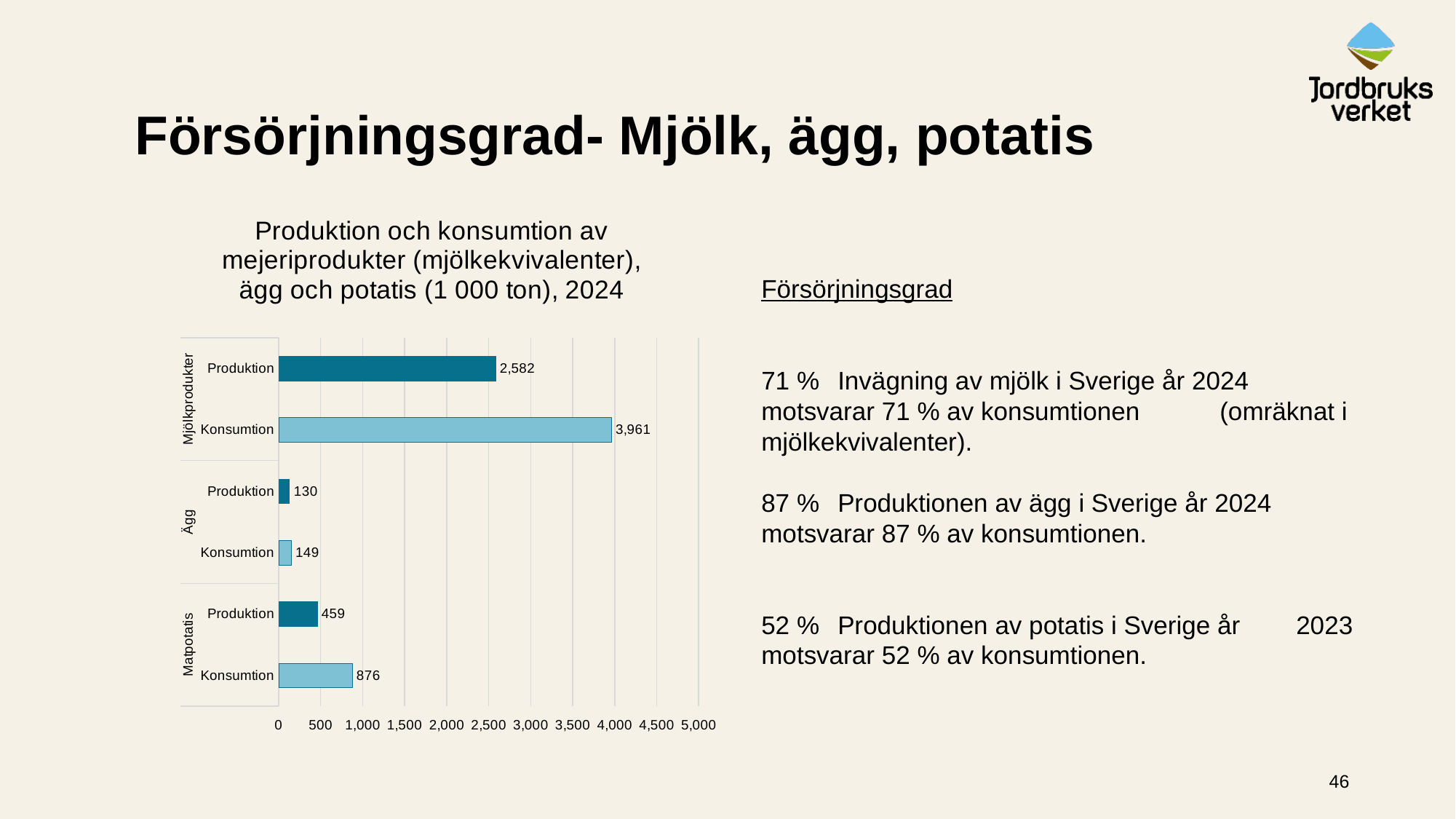
What is the value of Produktion for Ägg? 130 What is the value of Konsumtion for Mjölkprodukter? 3,961 What is the difference between Konsumtion and Produktion for Mjölkprodukter? 1,379 What is the difference between Konsumtion and Produktion for Matpotatis? 417 Which bar has the lowest value in the chart? Produktion for Ägg How many bars are plotted in the chart? 6 What is the value of Konsumtion for Matpotatis? 876 What kind of chart is shown on the slide? Bar chart Which is larger, Produktion for Matpotatis or Konsumtion for Ägg? Produktion for Matpotatis What is the value of Produktion for Mjölkprodukter? 2,582 Is the value of Produktion for Mjölkprodukter greater or less than 2,500? greater Which bar has the highest value in the chart? Konsumtion for Mjölkprodukter